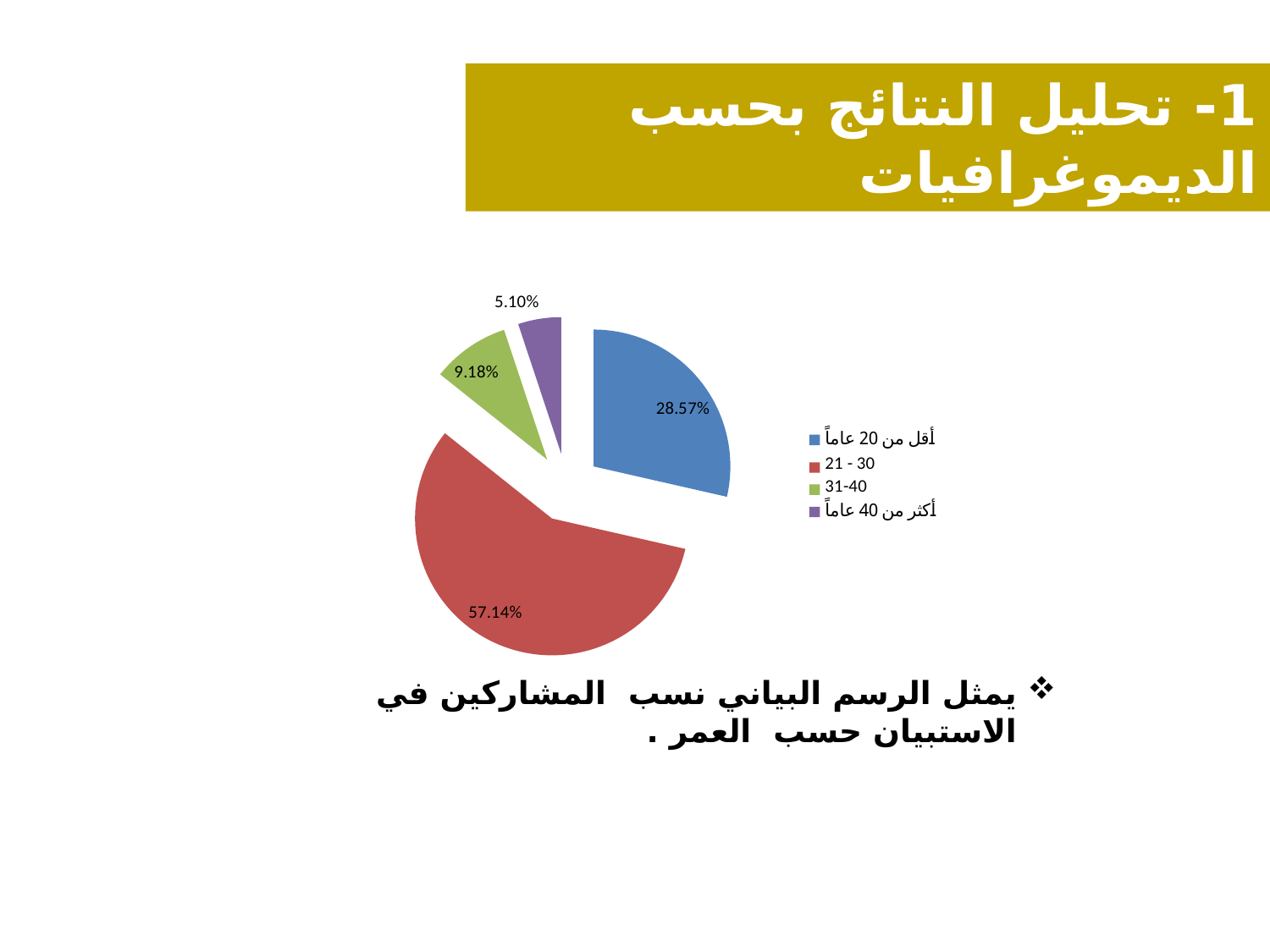
What is the difference between the 21 - 30 slice and the أقل من 20 عاماً slice? 28.57% What percentage of the pie is the slice for 31-40? 9.18% What colour is the slice for 21 - 30? red Which category has the largest slice of the pie? 21 - 30 Which is larger, the slice for 31-40 or the slice for أكثر من 40 عاماً? 31-40 What percentage of the pie is the slice for أقل من 20 عاماً? 28.57% How many entries does the legend list? 4 How many slices does the pie chart have? 4 Which category has the smallest slice of the pie? أكثر من 40 عاماً What type of chart is shown on the slide? pie chart What percentage of the pie is the slice for 21 - 30? 57.14% What percentage of the pie is the slice for أكثر من 40 عاماً? 5.10%